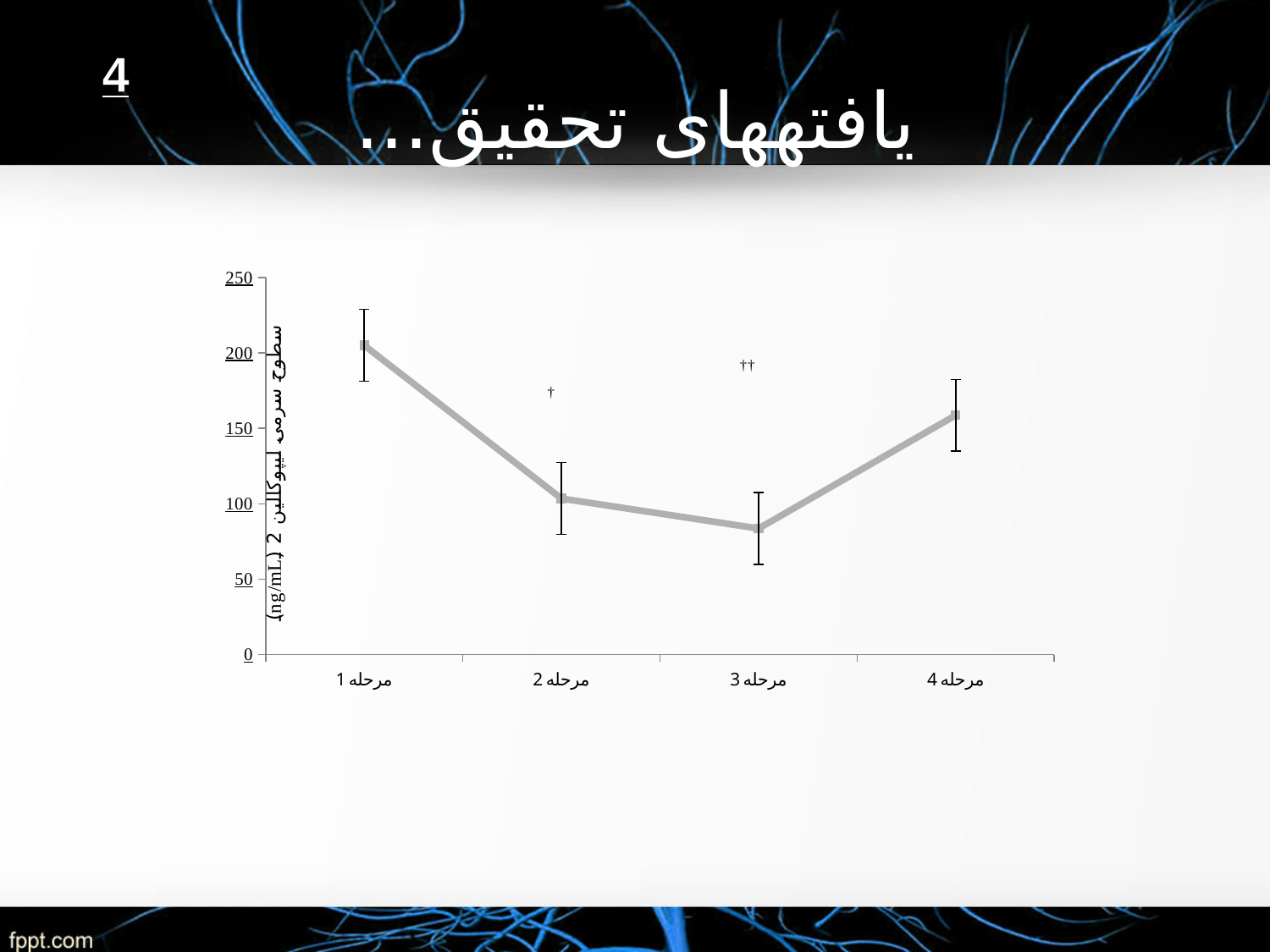
Is the value for مرحله 4 greater or less than 100? greater How many stages (categories) are plotted along the x axis? 4 Is the value for مرحله 2 greater or less than 150? less Do the values rise or fall from مرحله 1 to مرحله 3? fall Which stage has the highest value? مرحله 1 Is the value for مرحله 1 greater or less than 150? greater Which stage has the lowest value? مرحله 3 Which is larger, the value for مرحله 2 or the value for مرحله 4? مرحله 4 What kind of chart is shown on the slide? line chart Which is larger, the value for مرحله 1 or the value for مرحله 4? مرحله 1 What unit is given in the y-axis label? ng/mL